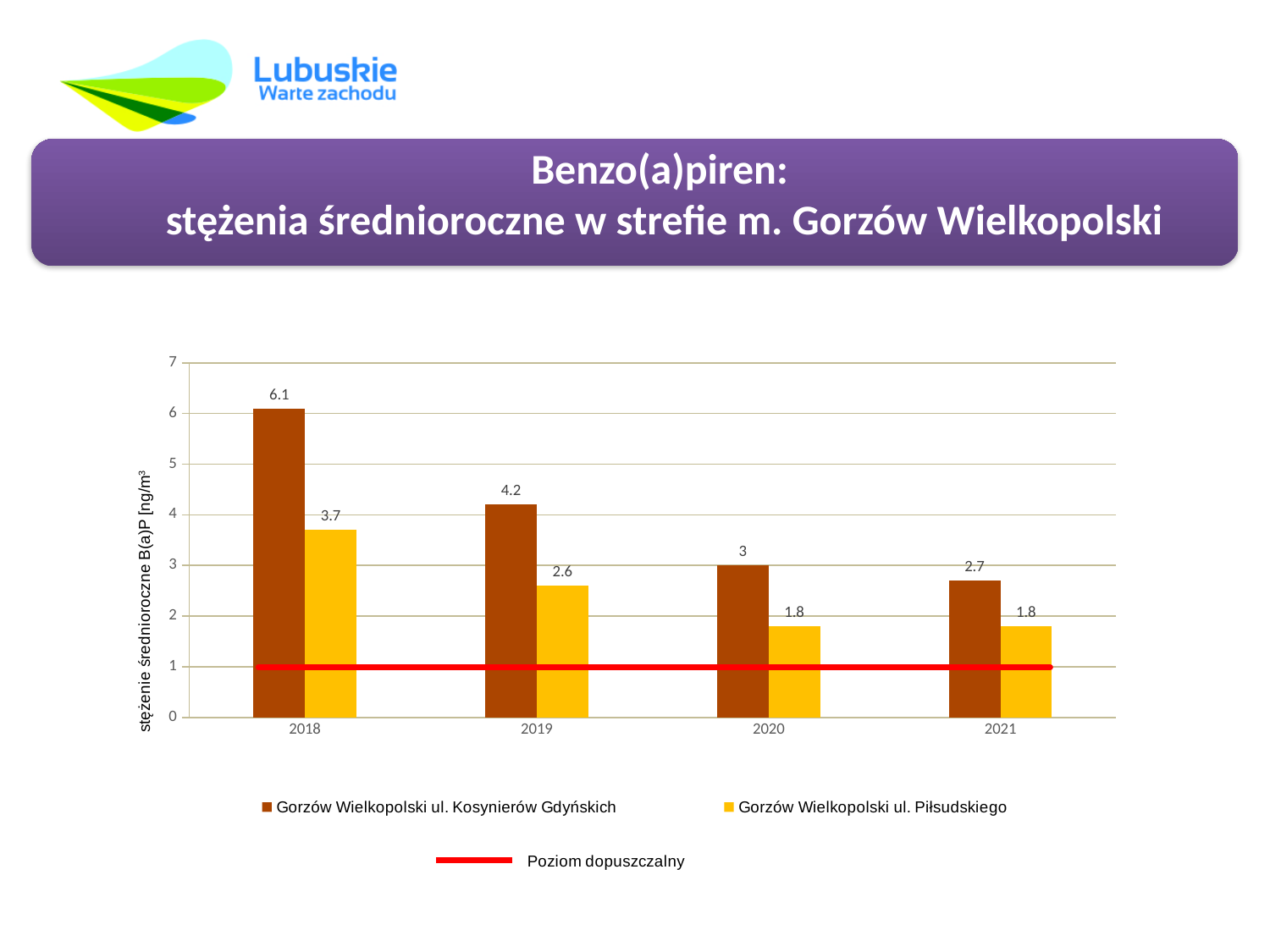
Which series has the larger value in 2020? Gorzów Wielkopolski ul. Kosynierów Gdyńskich How many bar series does the legend list? 2 In which year is the value for Gorzów Wielkopolski ul. Kosynierów Gdyńskich lowest? 2021 Do the values for Gorzów Wielkopolski ul. Piłsudskiego rise or fall from 2018 to 2021? fall What is the difference between the two series' values in 2018? 2.4 How many years are shown on the x axis? 4 What kind of chart is shown on the slide? bar chart What is the value for Gorzów Wielkopolski ul. Kosynierów Gdyńskich in 2018? 6.1 What is the value for Gorzów Wielkopolski ul. Piłsudskiego in 2019? 2.6 What is the difference between the Gorzów Wielkopolski ul. Kosynierów Gdyńskich values in 2018 and 2019? 1.9 What is the value for Gorzów Wielkopolski ul. Kosynierów Gdyńskich in 2021? 2.7 In which year is the value for Gorzów Wielkopolski ul. Kosynierów Gdyńskich highest? 2018